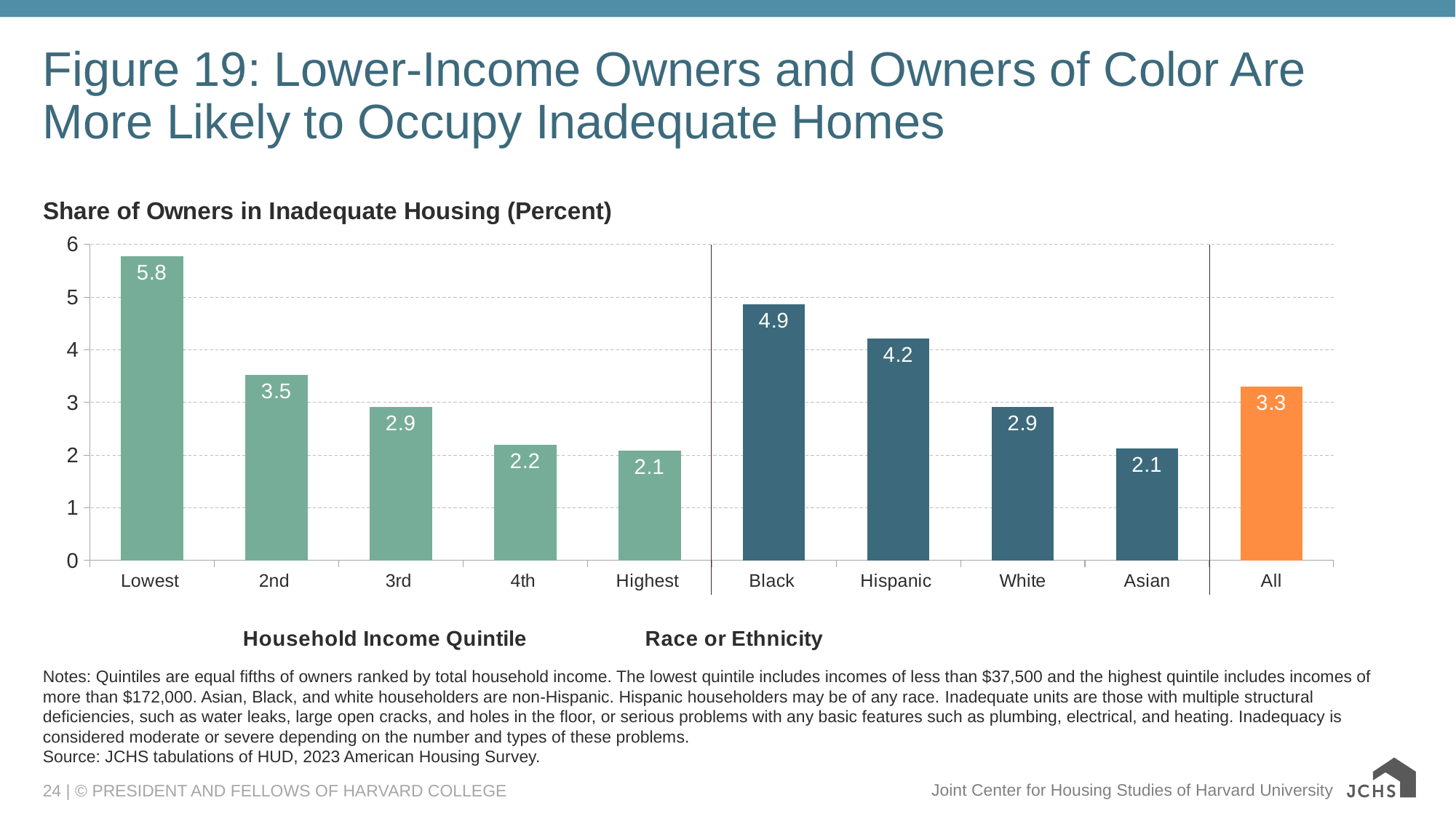
What is the value shown for the All category? 3.3 Do the values rise or fall from the Lowest to the Highest income quintile? Fall Is the value for Black owners greater or less than 4? greater How many categories are shown on the x axis of the chart? 10 Which is larger, the value for the 2nd income quintile or the value for Hispanic owners? Hispanic Among the race or ethnicity groups, which has the lowest share of owners in inadequate housing? Asian What colour is the bar for the All category? Orange What is the value shown for Hispanic owners? 4.2 Which category has the highest share of owners in inadequate housing? Lowest What is the difference between the values for Black and White owners? 2.0 What is the share of owners in inadequate housing for the Lowest income quintile? 5.8 What kind of chart is shown on the slide? Bar chart